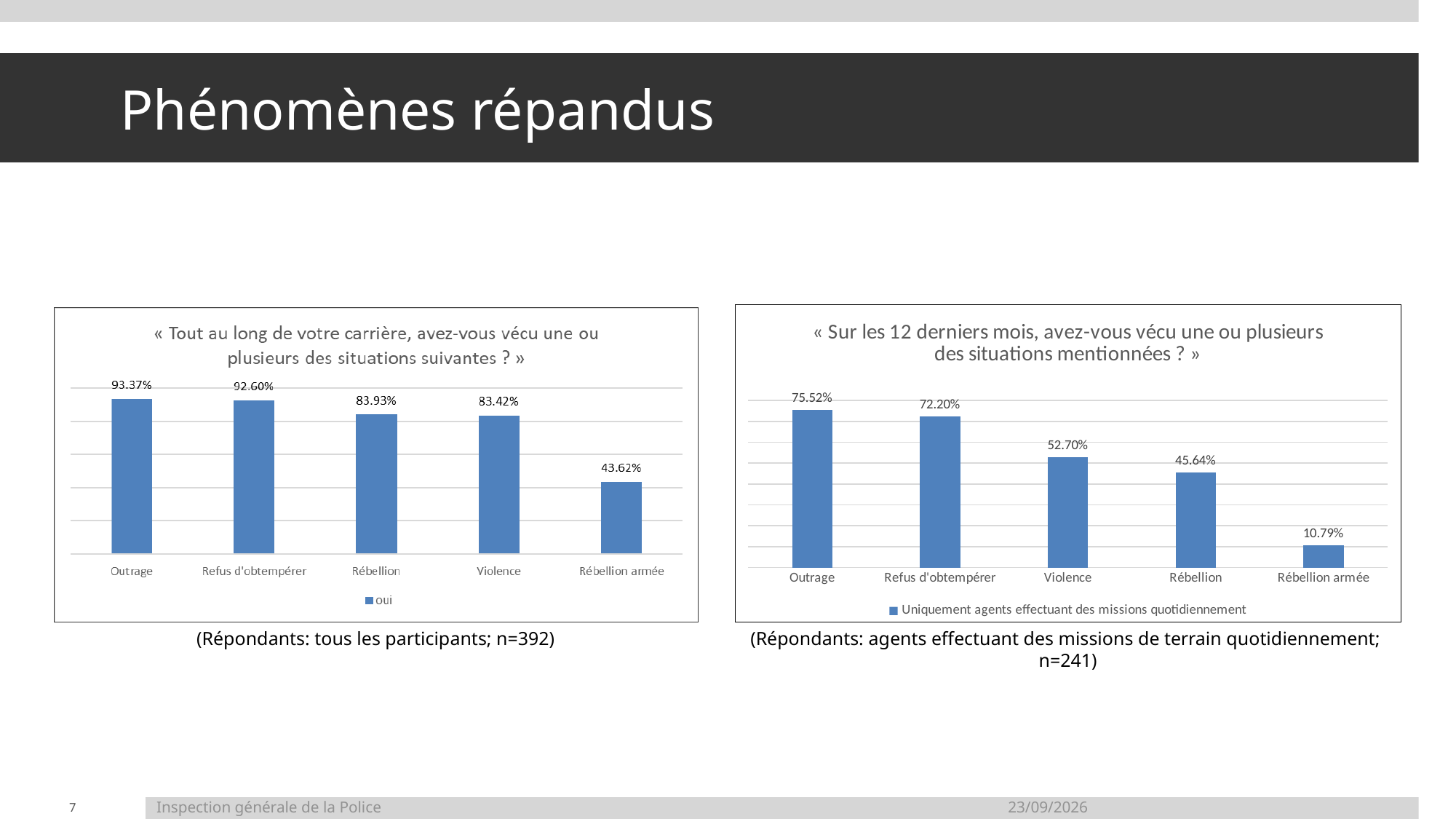
In the right chart (« Sur les 12 derniers mois... »), which is larger, the value for Violence or the value for Rébellion? Violence In the left chart (« Tout au long de votre carrière... »), what is the difference between the values for Refus d'obtempérer and Rébellion armée? 48.98% In the left chart (« Tout au long de votre carrière... »), what is the value for Rébellion armée? 43.62% What kind of chart is the left chart (« Tout au long de votre carrière... »)? Bar chart In the right chart (« Sur les 12 derniers mois... »), what is the difference between the values for Outrage and Rébellion? 29.88% What is the legend entry shown below the left chart (« Tout au long de votre carrière... »)? oui How many categories are shown in the right chart (« Sur les 12 derniers mois... »)? 5 In the right chart (« Sur les 12 derniers mois... »), which category has the highest value? Outrage In the left chart (« Tout au long de votre carrière... »), what is the value for Outrage? 93.37% In the right chart (« Sur les 12 derniers mois... »), what is the value for Violence? 52.70% In the left chart (« Tout au long de votre carrière... »), which category has the lowest value? Rébellion armée In the right chart (« Sur les 12 derniers mois... »), what is the value for Rébellion armée? 10.79%